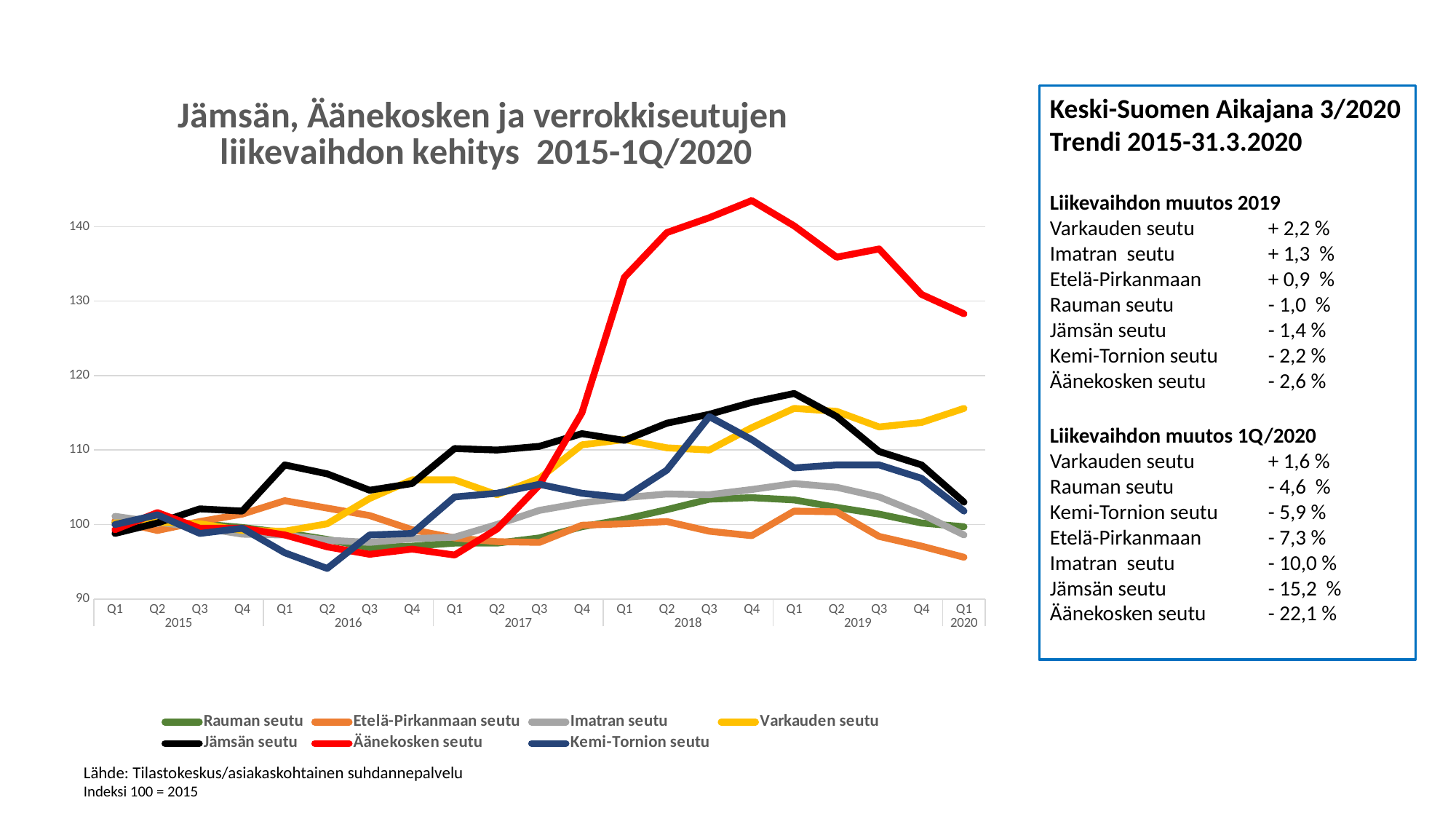
How many quarterly points are plotted along the x axis of the chart? 21 Is the value for Kemi-Tornion seutu in Q2 2016 greater or less than 100? less What colour is the Äänekosken seutu line in the chart? Red In Q1 2020, which is higher: Äänekosken seutu or Jämsän seutu? Äänekosken seutu Does the Äänekosken seutu line rise or fall from Q4 2018 to Q1 2020? Fall Which series reaches the highest value anywhere on the chart? Äänekosken seutu Is the value for Jämsän seutu in Q1 2019 greater or less than 110? greater Is the value for Äänekosken seutu in Q4 2018 greater or less than 140? greater Which series has the lowest value in Q1 2020? Etelä-Pirkanmaan seutu What kind of chart is shown on the slide? Line chart How many series does the chart's legend list? 7